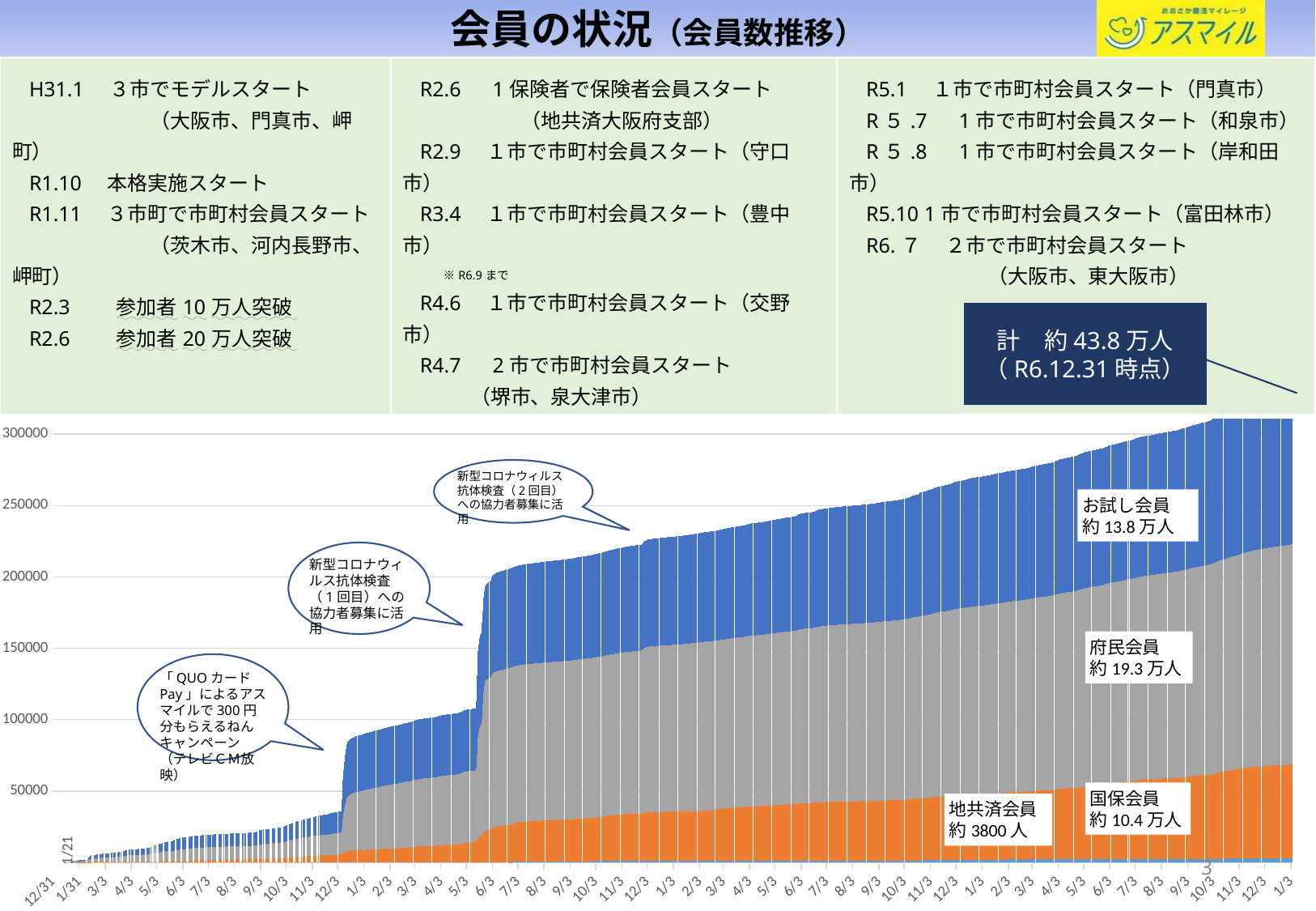
How many member categories are labelled in the stacked bars? 4 According to the label on the chart, how many 国保会員 are there? 約10.4万人 What is the title of the slide containing the chart? 会員の状況（会員数推移） Is the total member count at the right end of the chart greater or less than 300000? greater Which member category has the smallest number according to the chart labels? 地共済会員 According to the label on the chart, how many お試し会員 are there? 約13.8万人 Do the total member counts rise or fall over time along the x axis? rise What kind of chart is shown on the slide? stacked bar chart According to the label on the chart, how many 府民会員 are there? 約19.3万人 Which is larger, the number of お試し会員 or the number of 国保会員? お試し会員 Which member category has the largest number according to the chart labels? 府民会員 According to the label on the chart, how many 地共済会員 are there? 約3800人